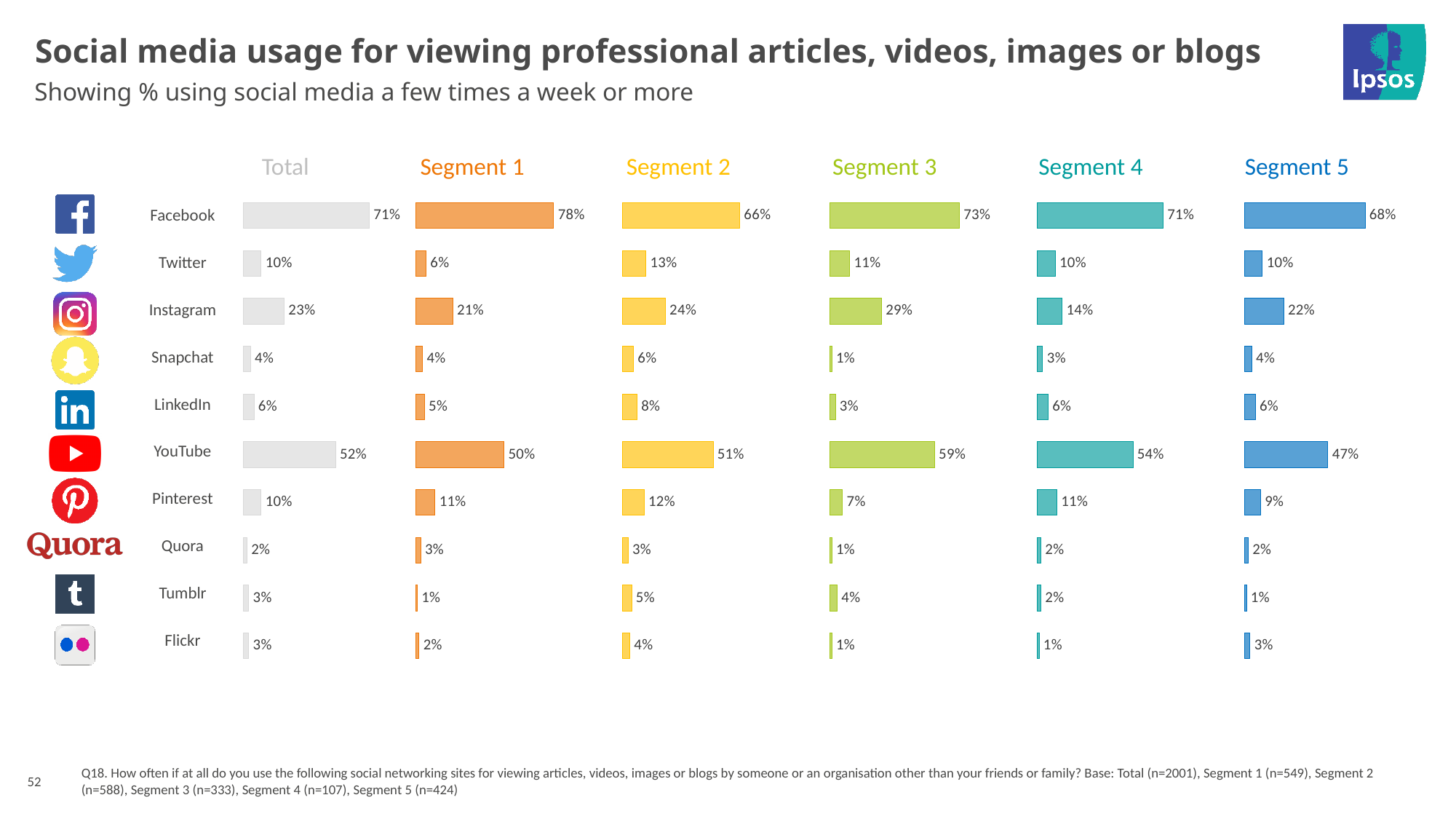
What type of chart is used for the Segment 2 data? bar chart In the Segment 3 chart, what is the difference between the YouTube value and the Instagram value? 30% Is the Facebook value larger in the Segment 1 chart or in the Segment 2 chart? Segment 1 In the Total chart, what is the value for Facebook? 71% In the Segment 4 chart, is the value for Instagram larger or smaller than the value for Pinterest? larger In the Segment 3 chart, what is the value for Instagram? 29% In the Segment 5 chart, what is the value for YouTube? 47% How many platforms are shown in the Total chart? 10 In the Segment 2 chart, what is the value for Twitter? 13% In the Segment 1 chart, which platform has the highest value? Facebook In the Segment 1 chart, what is the difference between the Facebook value and the YouTube value? 28% In the Segment 4 chart, which platform has the lowest value? Flickr